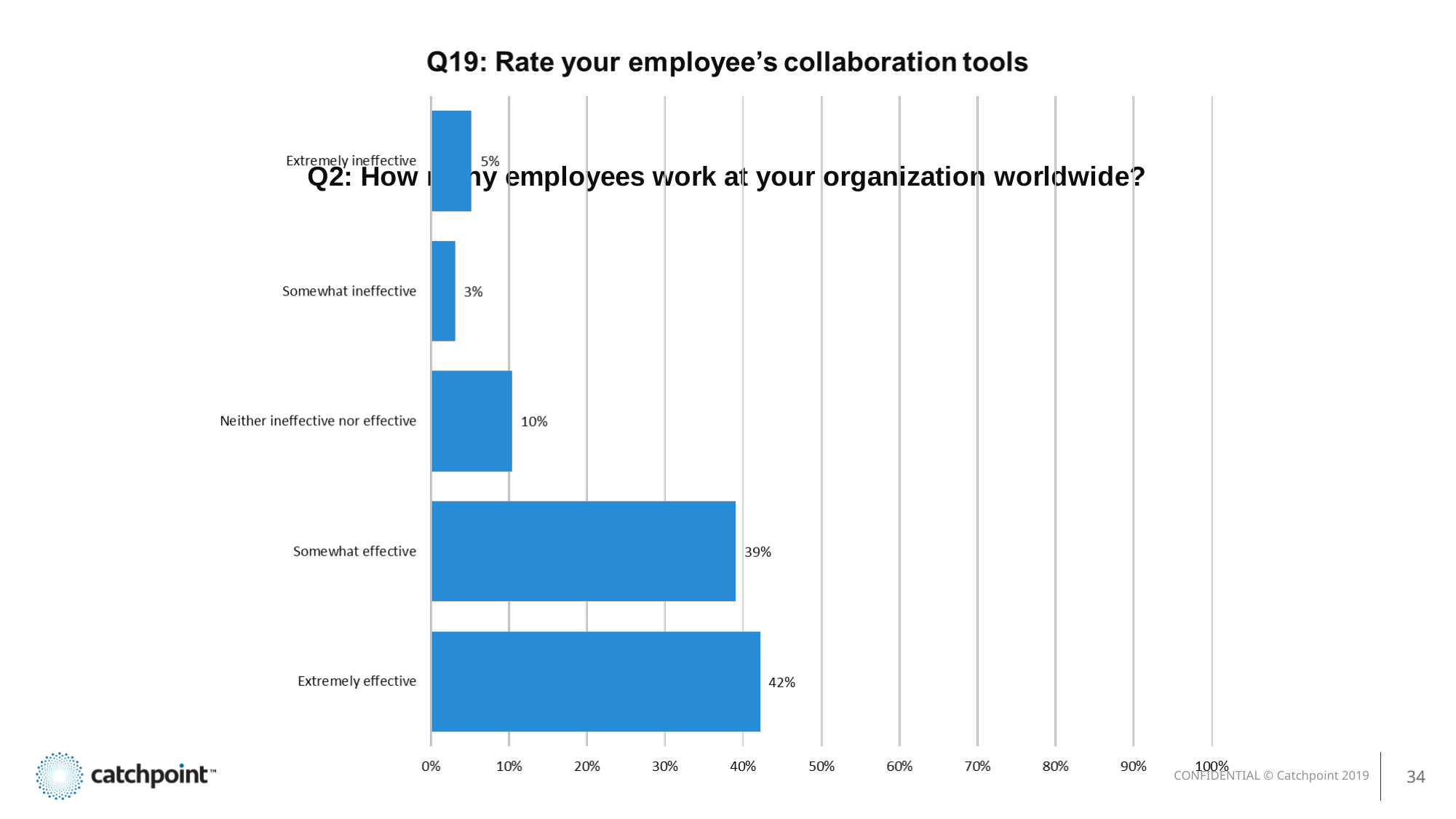
What is the difference between Extremely effective and Somewhat effective? 3% What is the value for Extremely ineffective? 5% What is the value for Extremely effective? 42% Which category has the highest value? Extremely effective How many categories are shown in the chart? 5 What is the value for Somewhat effective? 39% Which is larger, Extremely ineffective or Somewhat ineffective? Extremely ineffective Which category has the lowest value? Somewhat ineffective What kind of chart is shown on the slide? Bar chart What is the value for Neither ineffective nor effective? 10% What is the value for Somewhat ineffective? 3%